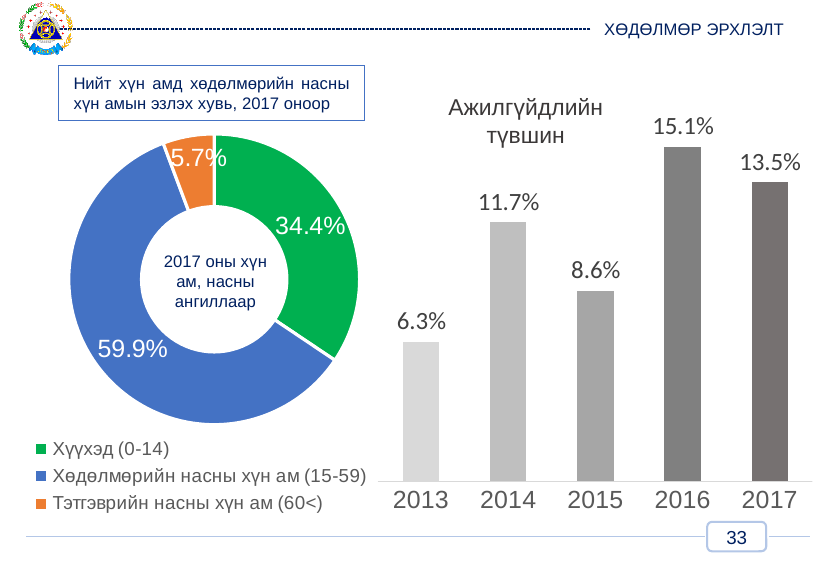
In the bar chart titled "Ажилгүйдлийн түвшин", which year has the highest value? 2016 What type of chart is the chart on the right side of the slide? bar chart In the bar chart titled "Ажилгүйдлийн түвшин", which year has the lowest value? 2013 In the bar chart titled "Ажилгүйдлийн түвшин", does the value rise or fall from 2016 to 2017? fall In the bar chart titled "Ажилгүйдлийн түвшин", what is the value for 2016? 15.1% In the bar chart titled "Ажилгүйдлийн түвшин", what is the difference between the values for 2016 and 2017? 1.6% In the bar chart titled "Ажилгүйдлийн түвшин", which is larger, the value for 2014 or the value for 2015? 2014 In the bar chart titled "Ажилгүйдлийн түвшин", what is the value for 2013? 6.3% In the doughnut chart on the left, what share is shown for "Тэтгэврийн насны хүн ам (60<)"? 5.7% In the doughnut chart on the left, which category has the largest slice? Хөдөлмөрийн насны хүн ам (15-59) In the doughnut chart on the left, what share is shown for "Хөдөлмөрийн насны хүн ам (15-59)"? 59.9% How many years are shown in the bar chart titled "Ажилгүйдлийн түвшин"? 5